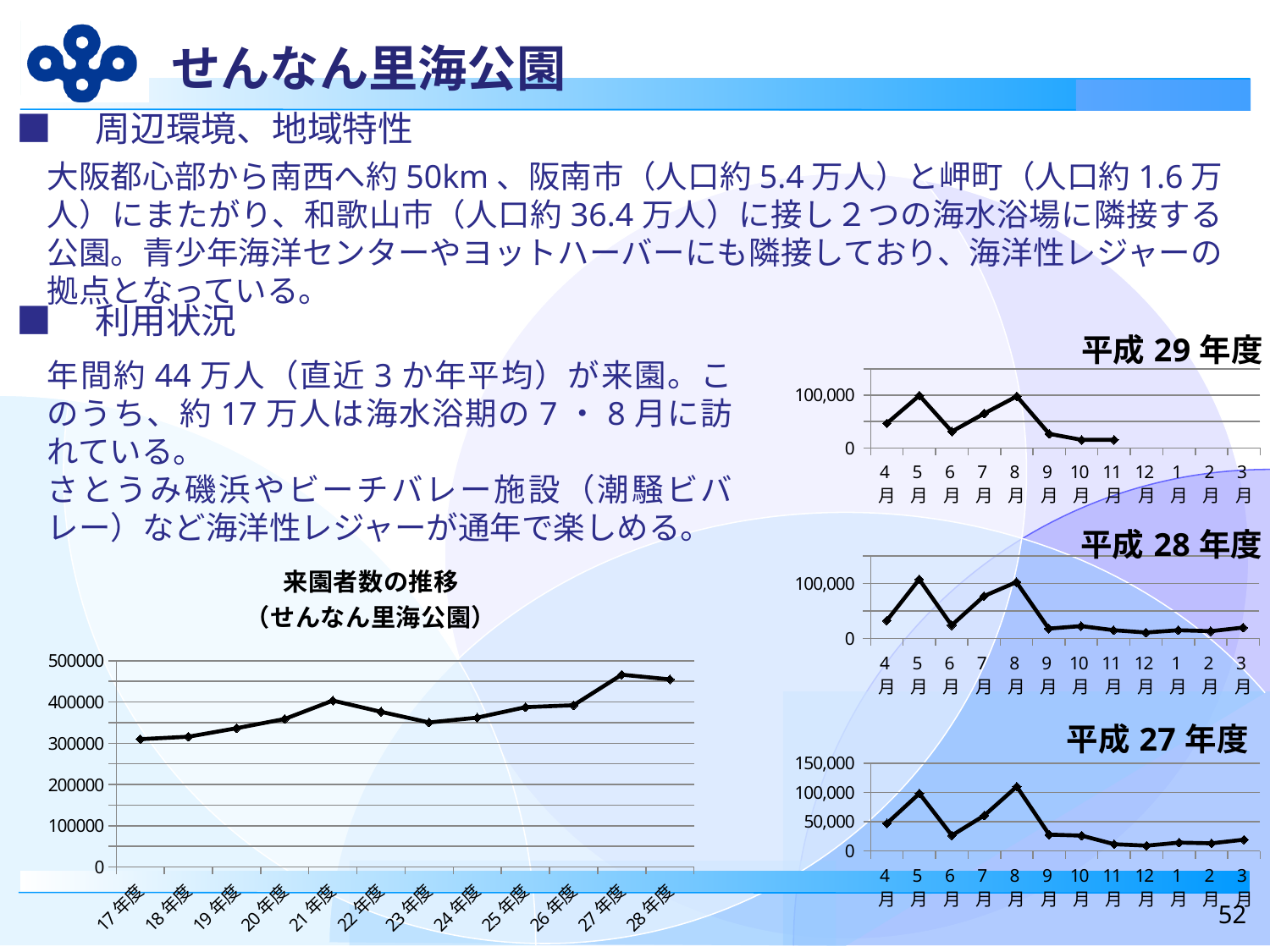
In the 来園者数の推移（せんなん里海公園） chart, which is larger, the value for 21年度 or the value for 23年度? 21年度 In the 来園者数の推移（せんなん里海公園） chart, do the values generally rise or fall from 17年度 to 28年度? rise In the 平成27年度 chart, is the value for 6月 greater or less than 50,000? less In the 平成27年度 chart, which is larger, the value for 8月 or the value for 11月? 8月 In the 来園者数の推移（せんなん里海公園） chart, which fiscal year has the highest number of visitors? 27年度 What kind of chart is the 来園者数の推移（せんなん里海公園） chart? line chart In the 来園者数の推移（せんなん里海公園） chart, is the value for 27年度 greater or less than 400000? greater In the 平成29年度 chart, which is larger, the value for 8月 or the value for 10月? 8月 In the 平成29年度 chart, is the value for 6月 greater or less than 100,000? less In the 来園者数の推移（せんなん里海公園） chart, how many fiscal years are plotted on the x axis? 12